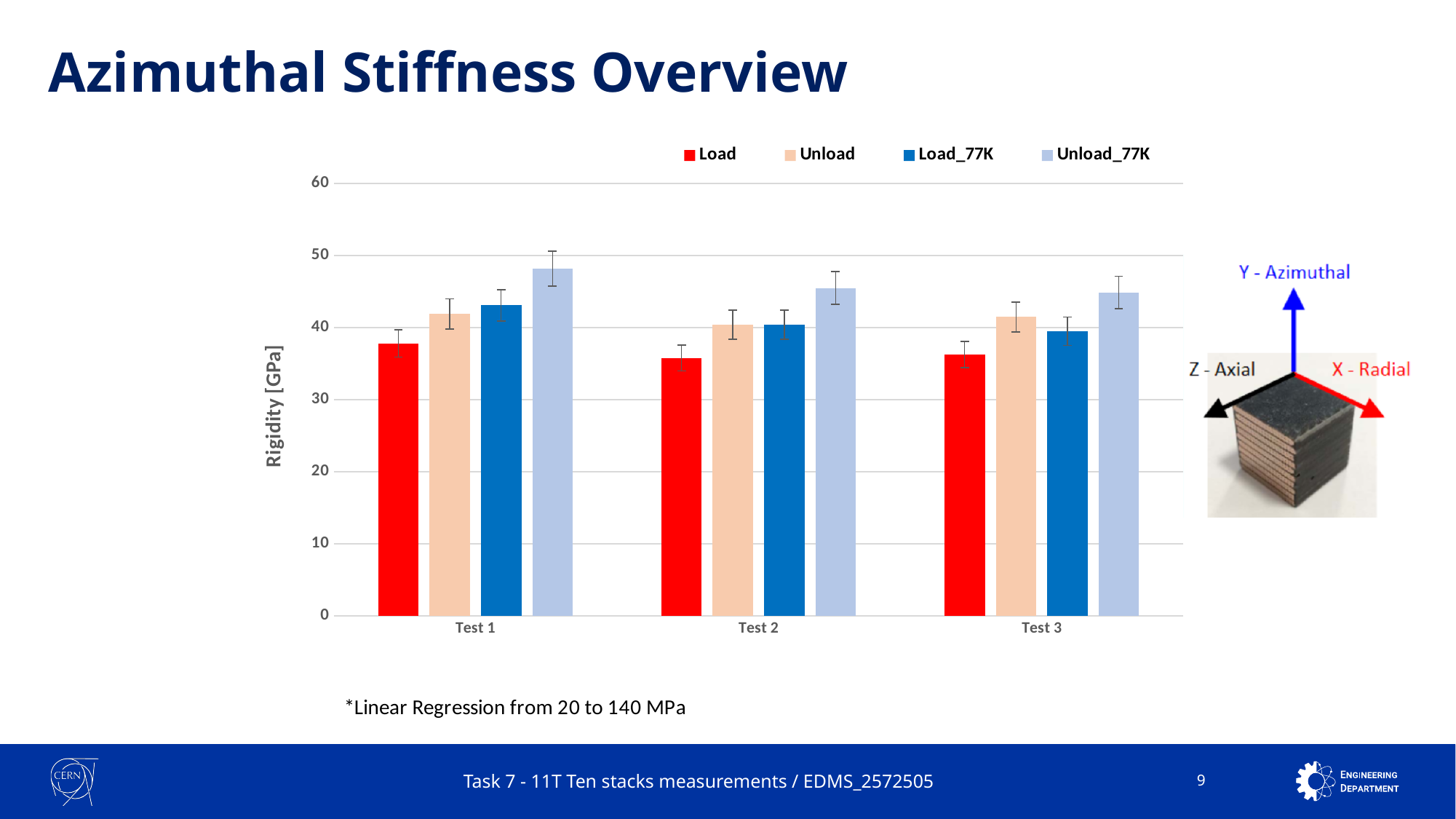
What is the label of the y axis? Rigidity [GPa] Is the Unload_77K value for Test 1 greater or less than 40? greater Is the Load value for Test 2 greater or less than 40? less Which series has the highest value for Test 1? Unload_77K Is the Load value for Test 1 greater or less than 40? less How many test categories are shown on the x axis? 3 For Test 1, which is larger: the Load value or the Unload_77K value? Unload_77K What kind of chart is shown on the slide? bar chart Which series has the lowest value for Test 2? Load How many series does the legend list? 4